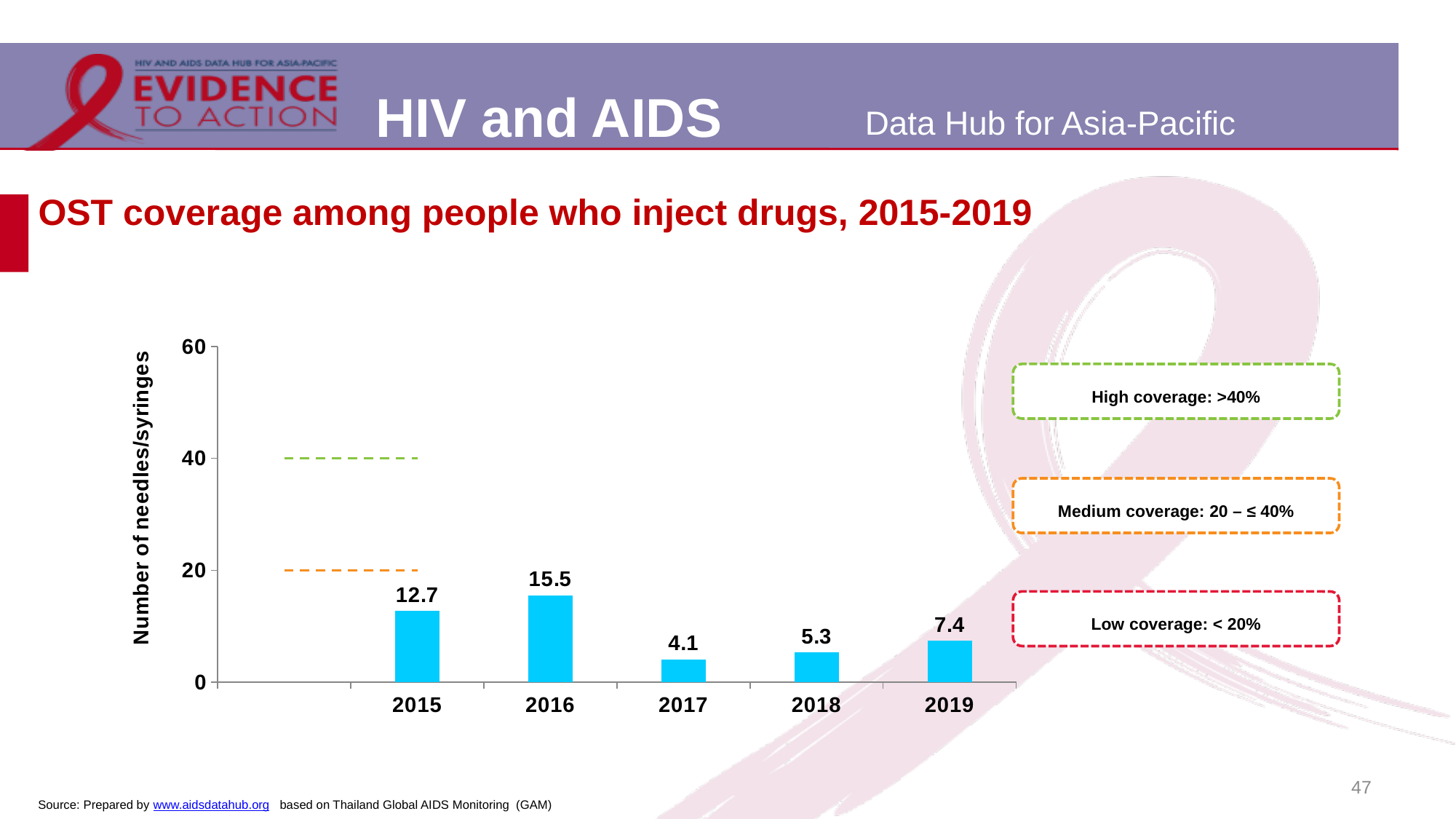
What is the difference between the values for 2016 and 2015? 2.8 Is the value for 2016 greater or less than 20? less What is the value for 2015? 12.7 Which is larger, the value for 2018 or the value for 2019? 2019 Which year has the lowest value? 2017 Which year has the highest value? 2016 What is the title of the chart? OST coverage among people who inject drugs, 2015-2019 What is the value for 2019? 7.4 What kind of chart is shown? bar chart What is the value for 2017? 4.1 What is the difference between the values for 2019 and 2018? 2.1 How many years are shown on the x axis? 5